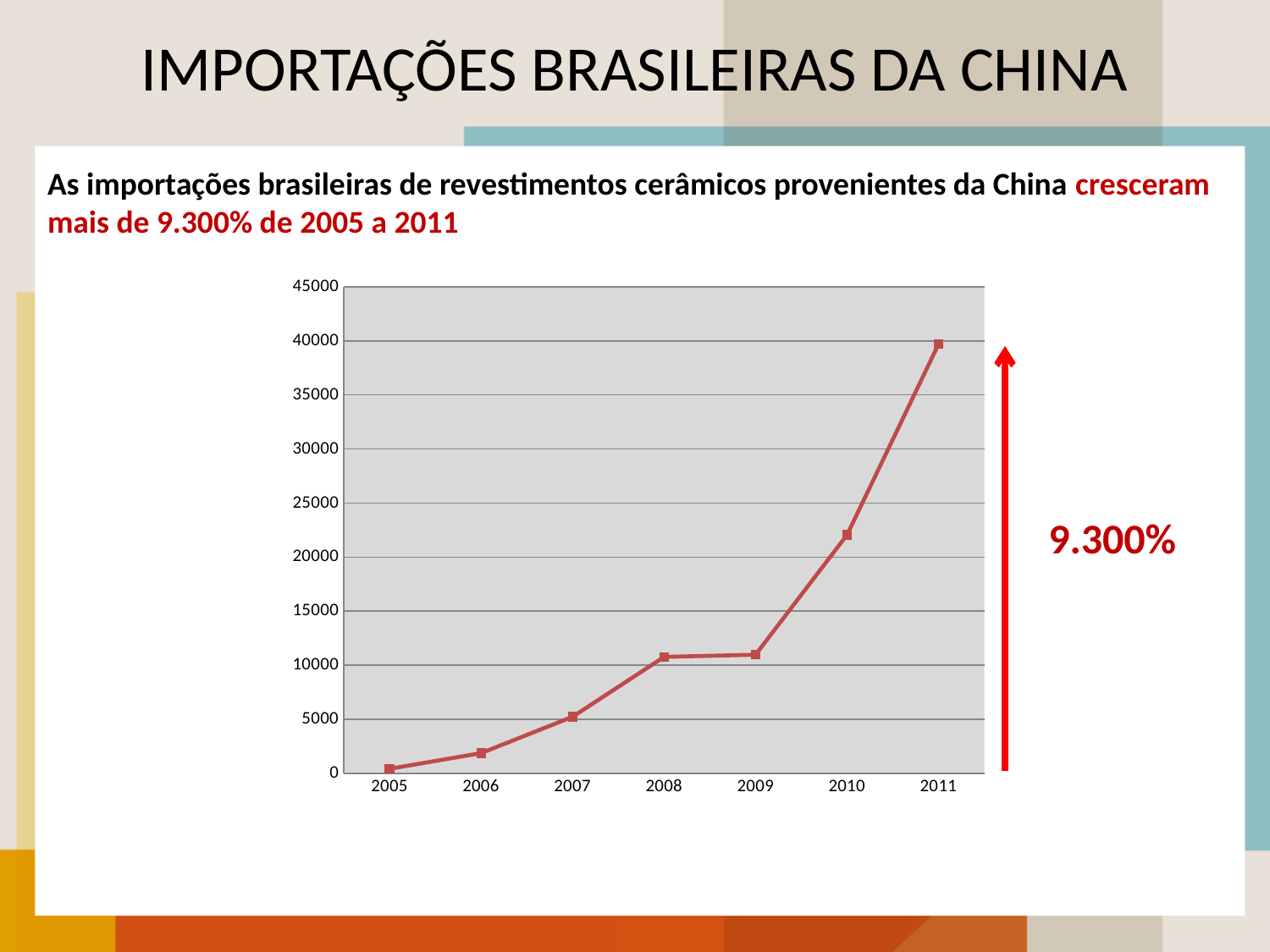
Which year has the larger value, 2010 or 2008? 2010 Which year has the lowest value in the chart? 2005 Is the value for 2006 greater or less than 5000? less Is the value for 2009 greater or less than 15000? less How many years are plotted on the x axis of the chart? 7 Do the values rise or fall from 2005 to 2011? rise Is the value for 2011 greater or less than 35000? greater Which year has the highest value in the chart? 2011 What is the title of the slide containing the chart? IMPORTAÇÕES BRASILEIRAS DA CHINA What kind of chart is shown on the slide? line chart What percentage is written next to the red arrow beside the chart? 9.300%